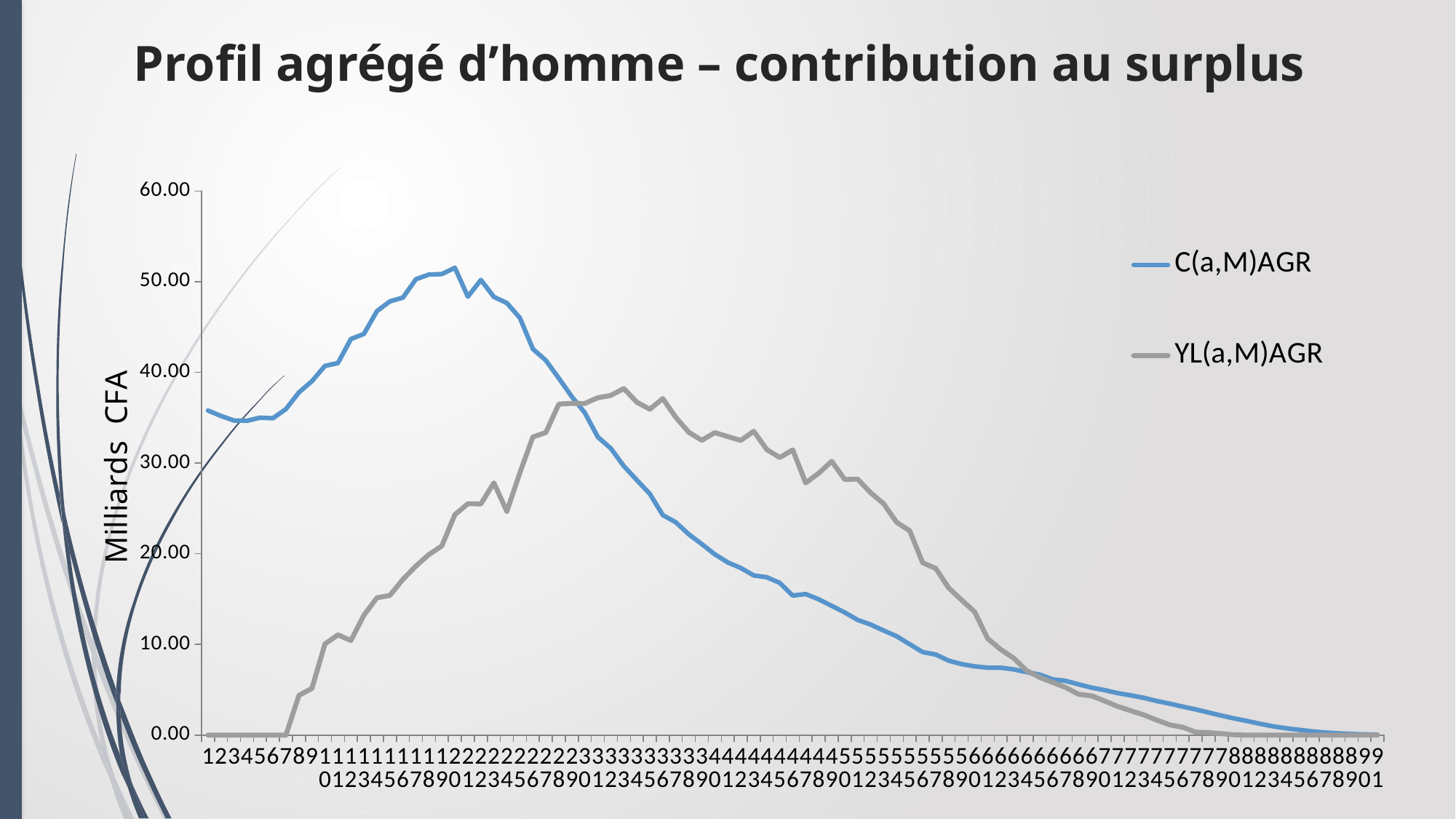
How many series does the legend list? 2 At age 10, which series has the higher value, C(a,M)AGR or YL(a,M)AGR? C(a,M)AGR Is the value of YL(a,M)AGR at age 1 greater or less than 10.00? less What are the two series named in the legend? C(a,M)AGR and YL(a,M)AGR Is the value of C(a,M)AGR at age 1 greater or less than 30.00? greater What is the label on the vertical axis? Milliards CFA Does the YL(a,M)AGR series rise or fall between age 60 and age 80? fall Is the highest value reached by the C(a,M)AGR series greater or less than 50.00? greater At age 50, which series has the higher value, C(a,M)AGR or YL(a,M)AGR? YL(a,M)AGR Which series reaches its peak at a younger age, C(a,M)AGR or YL(a,M)AGR? C(a,M)AGR What kind of chart is shown on the slide? line chart